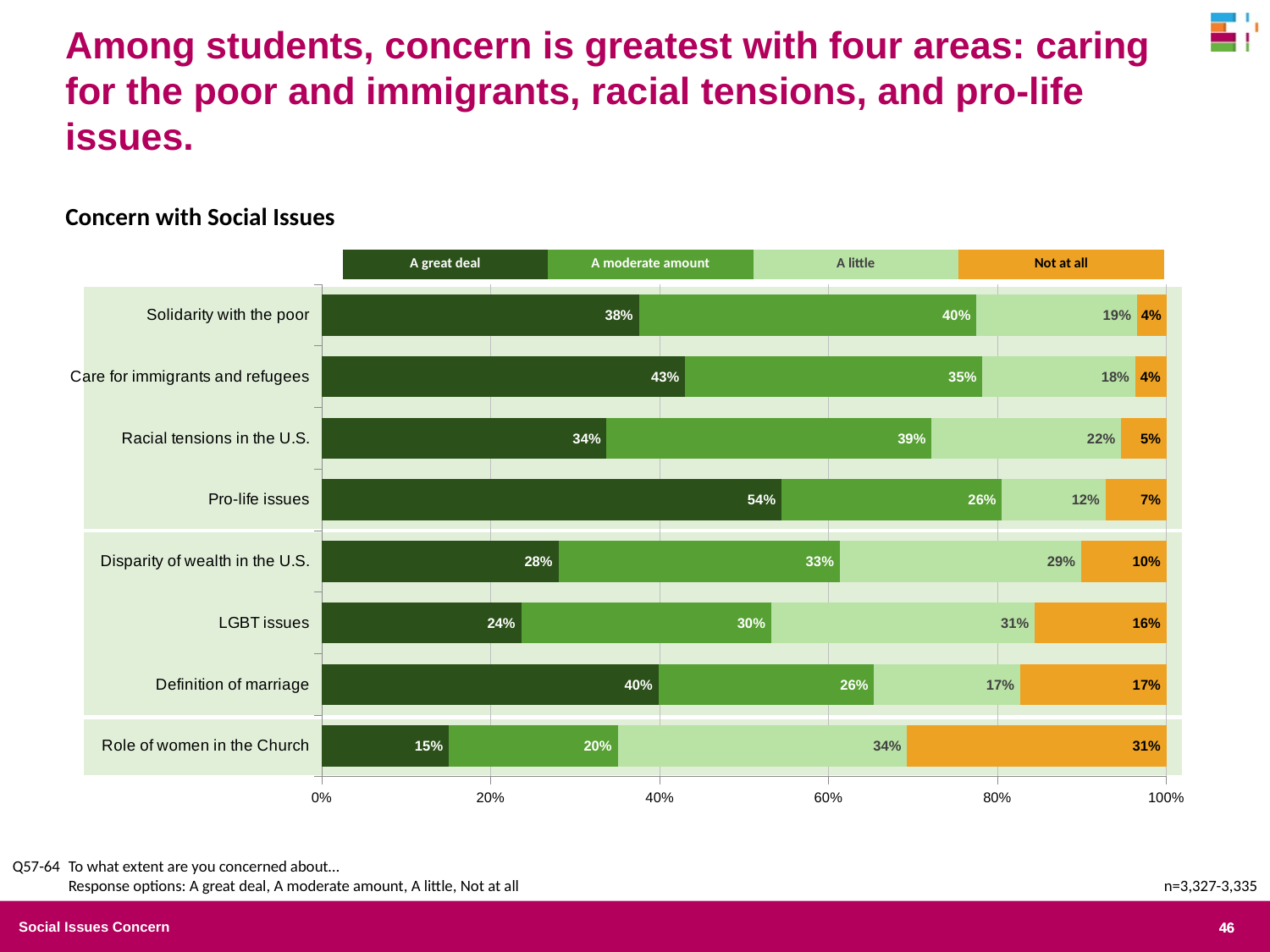
What is the title of the chart? Concern with Social Issues Which social issue has the lowest 'A great deal' percentage? Role of women in the Church What percentage of students are concerned 'A great deal' about Pro-life issues? 54% What percentage of students are concerned 'A moderate amount' about Solidarity with the poor? 40% What type of chart is shown on the slide? Stacked bar chart Which has a larger 'Not at all' percentage: LGBT issues or Disparity of wealth in the U.S.? LGBT issues Which social issue has the highest 'A great deal' percentage? Pro-life issues What is the total of the four segments for Definition of marriage? 100% What is the difference between the 'A great deal' percentages for Care for immigrants and refugees and Racial tensions in the U.S.? 9% How many social issues are listed in the chart? 8 What percentage of students are 'Not at all' concerned about the Role of women in the Church? 31% How many response categories does the legend list? 4